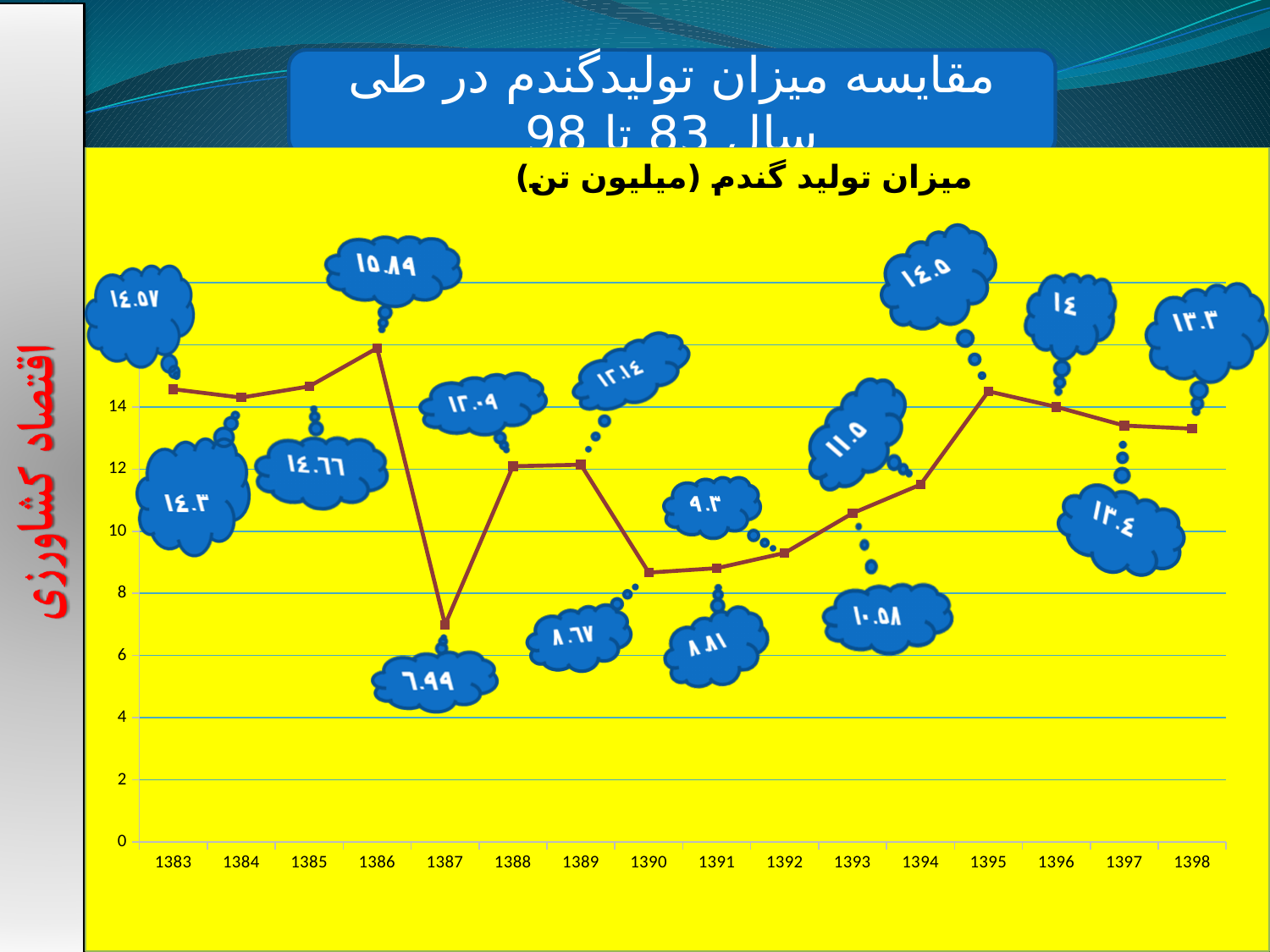
Which year has the larger value, 1389 or 1392? 1389 Which year has the highest wheat production in the chart? 1386 Which year has the lowest wheat production in the chart? 1387 Do the values rise or fall from 1390 to 1395? rise Is the value for 1386 greater or less than 14? greater Is the value for 1394 greater or less than 10? greater What kind of chart is shown on the slide? line chart How many years are plotted along the x axis of the chart? 16 Is the value for 1387 greater or less than 8? less Which year has the larger value, 1383 or 1390? 1383 Do the values rise or fall from 1395 to 1398? fall